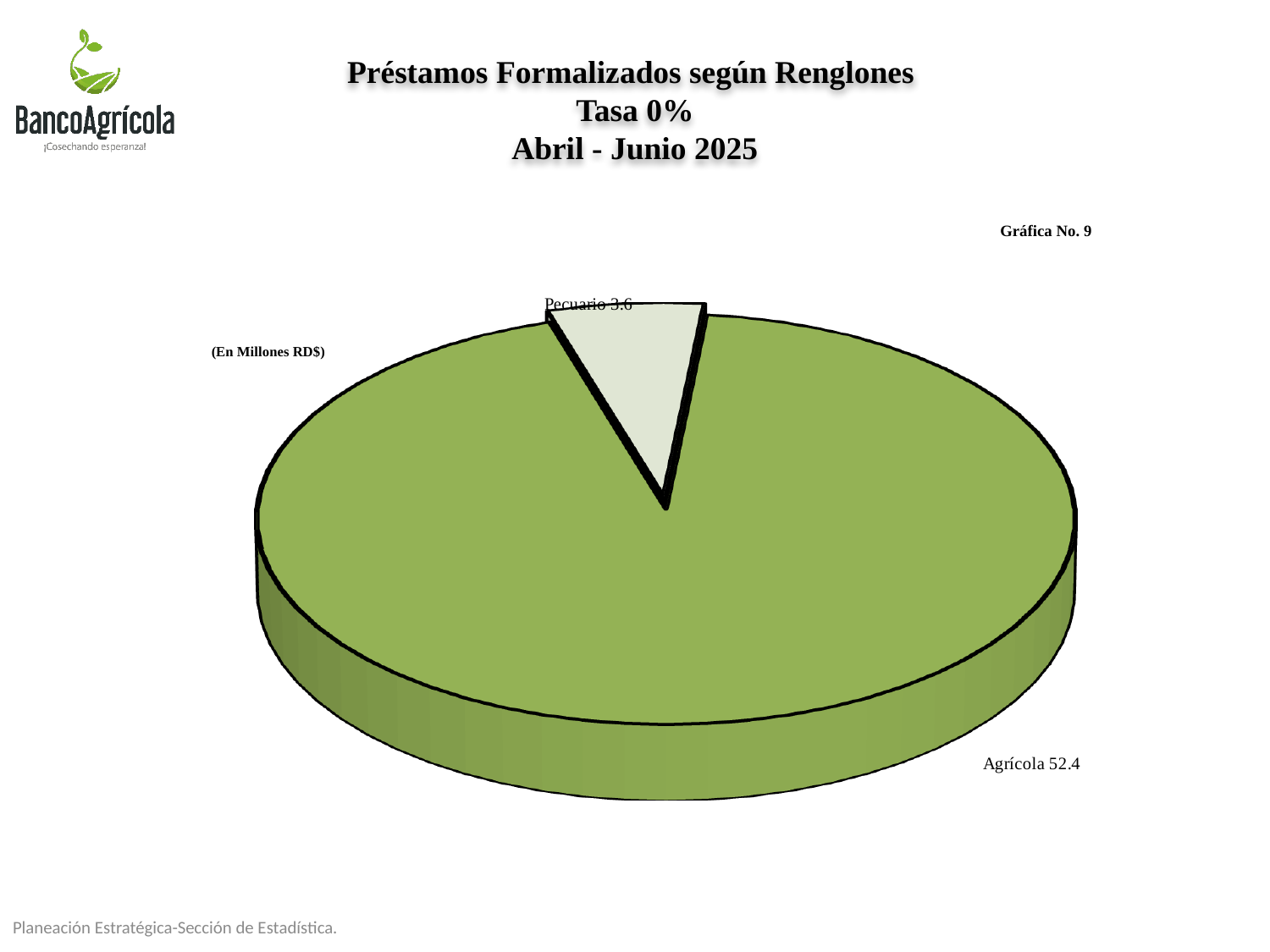
Which category has the largest slice of the pie? Agrícola Which category has the smallest slice of the pie? Pecuario What share of the pie does Pecuario represent, to one decimal place? 6.4% In what units are the values in the chart expressed? En Millones RD$ What is the total of the two values shown in the pie chart? 56.0 What is the value for Agrícola? 52.4 How many categories are shown in the pie chart? 2 What is the difference between the values for Agrícola and Pecuario? 48.8 Which is larger, the value for Agrícola or the value for Pecuario? Agrícola What kind of chart is shown on the slide? Pie chart What period does the chart title refer to? Abril - Junio 2025 What is the value for Pecuario? 3.6